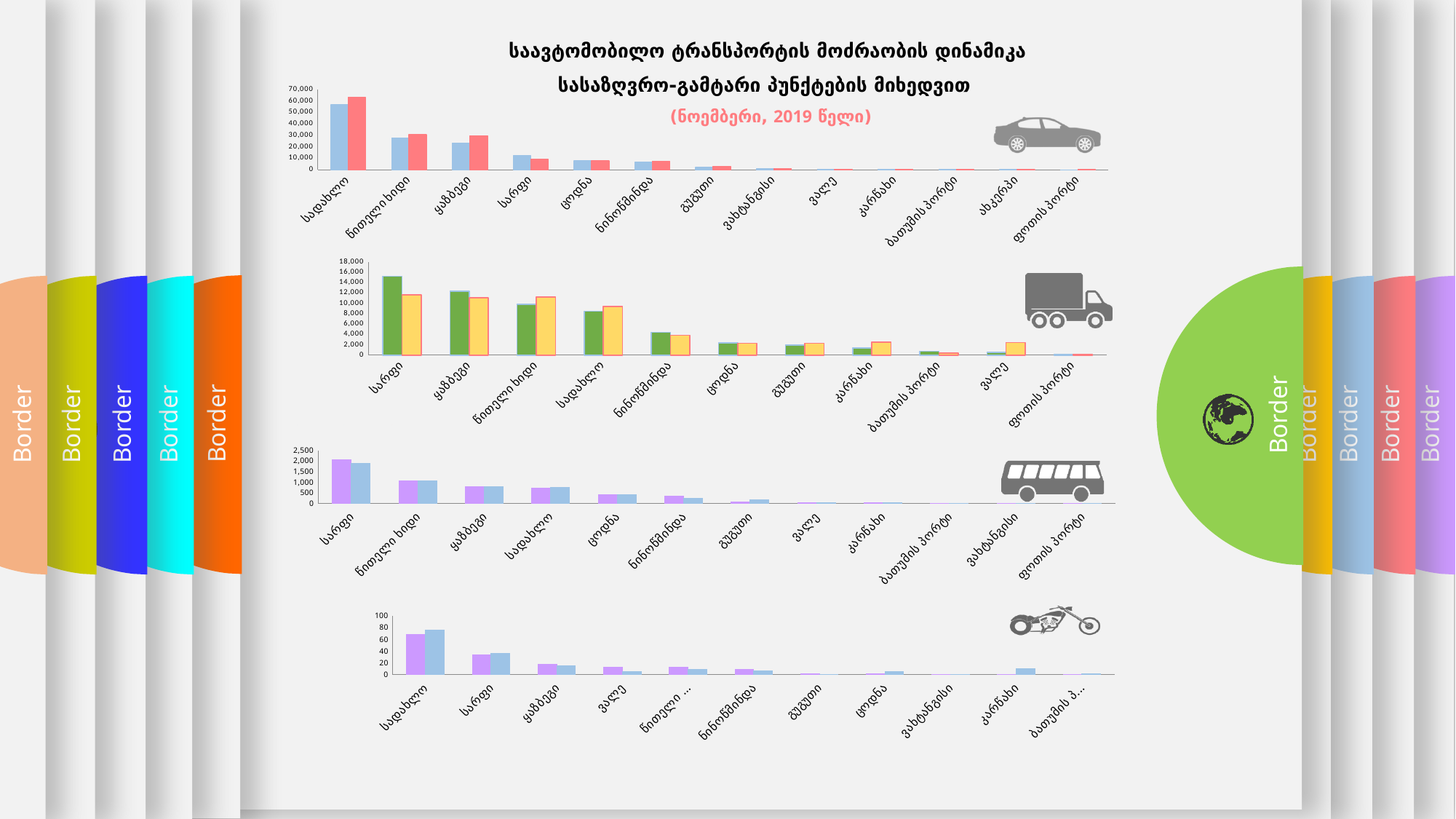
In the bottom chart (motorcycle icon), which category has the highest values? სადახლო In the third chart (bus icon), is the purple bar for სარფი greater or less than 1,500? greater In the second chart (truck icon), which category has the tallest green bar? სარფი In the top chart (car icon), which category has the highest values? სადახლო In the top chart (car icon), is the red bar for სადახლო greater or less than 50,000? greater In the top chart (car icon), do the values generally rise or fall from left to right along the x axis? fall How many categories are shown on the x axis of the top chart (car icon)? 13 In the second chart (truck icon), is the green bar for სარფი greater or less than 12,000? greater What period is given in the subtitle under the main title of the slide? (ნოემბერი, 2019 წელი) In the second chart (truck icon), which is larger for სარფი, the green bar or the yellow bar? the green bar What kind of chart is the top chart (with the car icon)? bar chart How many categories are shown on the x axis of the third chart (bus icon)? 12